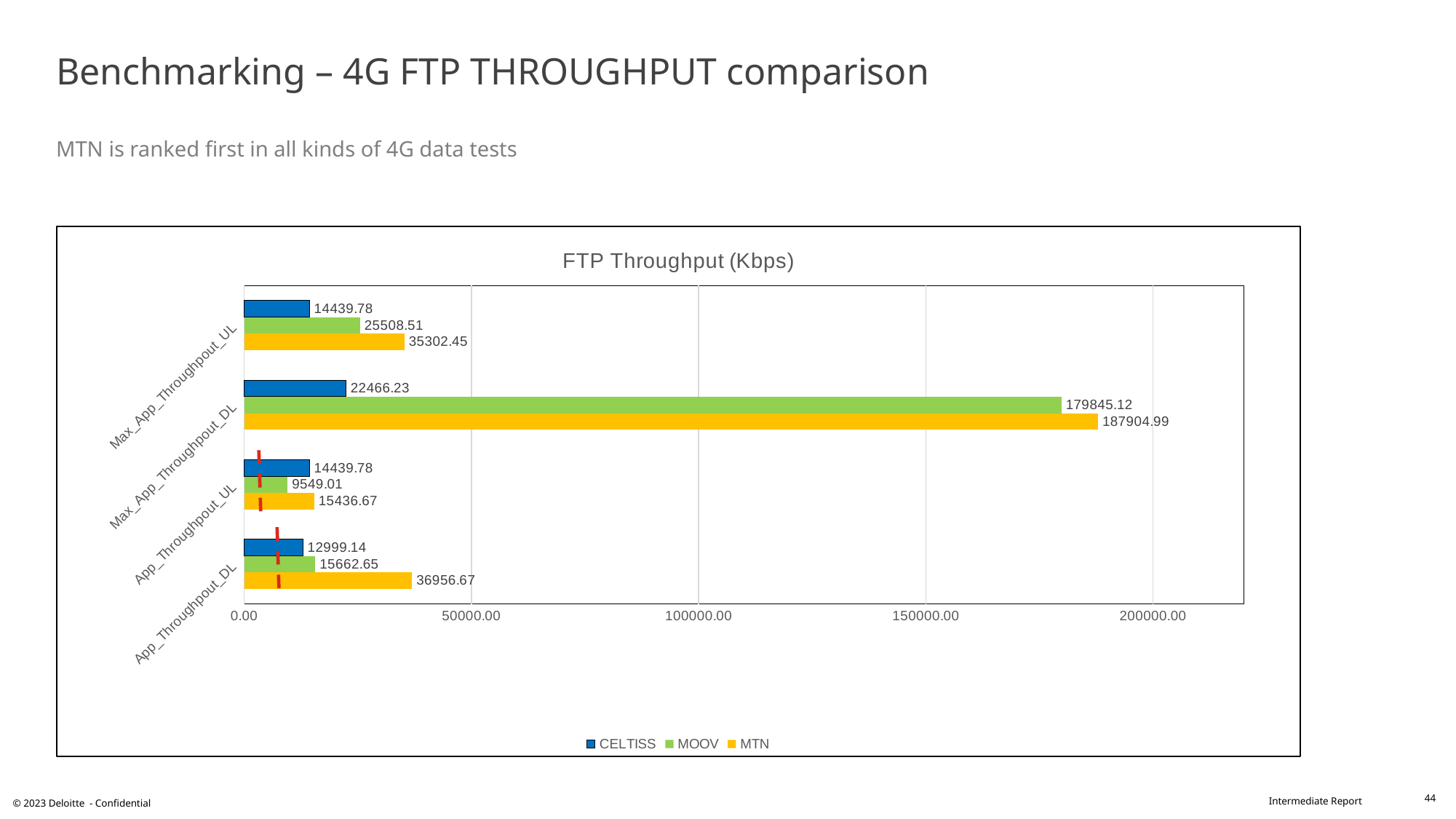
Which series has the lowest value for App_Throughpout_UL? MOOV Which series has the highest value for App_Throughpout_DL? MTN What is the MOOV value for App_Throughpout_UL? 9549.01 What is the CELTISS value for App_Throughpout_DL? 12999.14 What kind of chart is shown on the slide? Bar chart Which is larger for Max_App_Throughpout_UL: the CELTISS value or the MOOV value? MOOV How many series does the legend list? 3 How many categories are shown on the chart? 4 What is the MTN value for Max_App_Throughpout_DL? 187904.99 What is the difference between the MTN and MOOV values for Max_App_Throughpout_DL? 8059.87 What is the difference between the MTN and CELTISS values for App_Throughpout_DL? 23957.53 What is the MOOV value for Max_App_Throughpout_UL? 25508.51